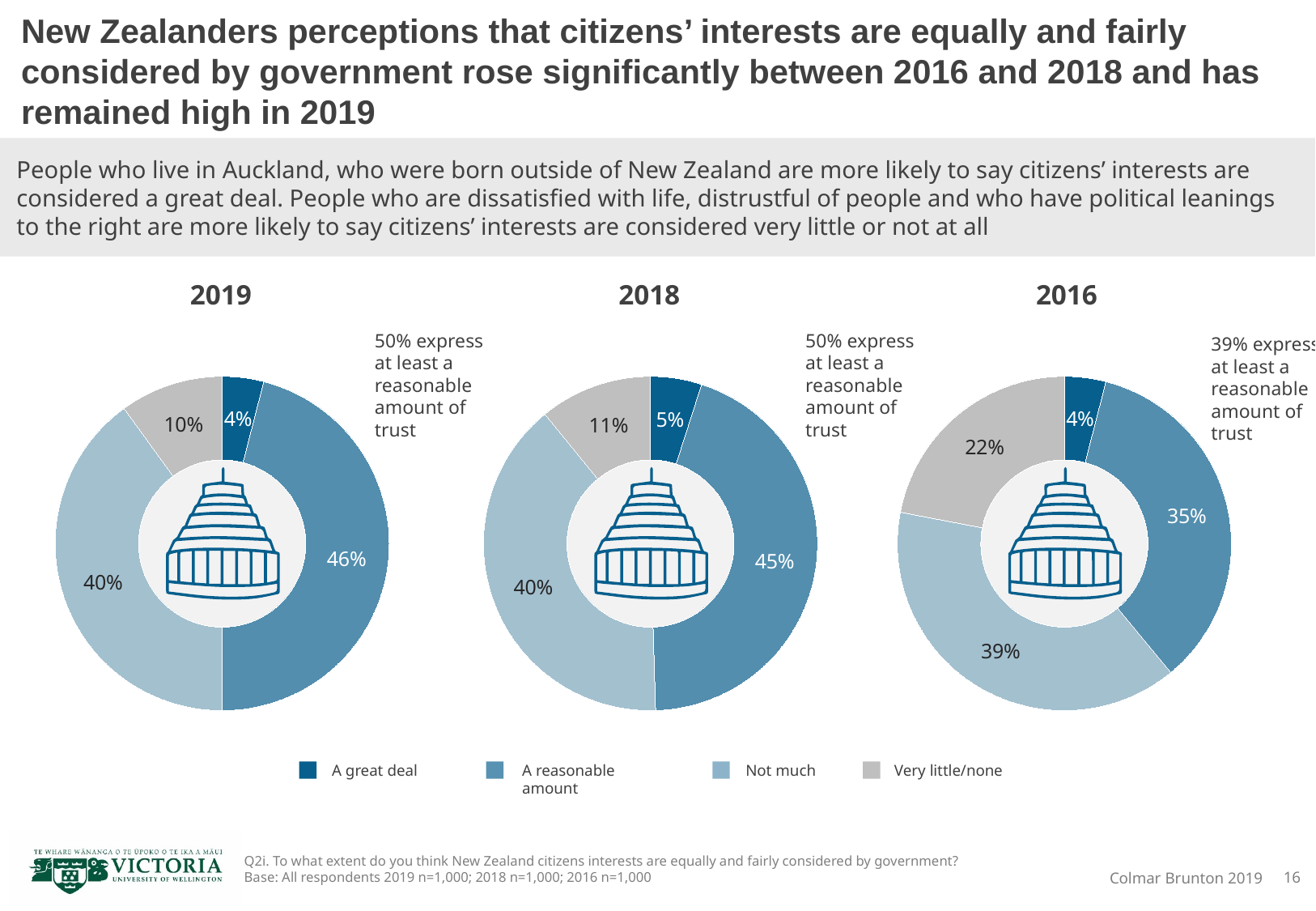
In the 2019 chart, which category has the smallest share? A great deal What is the difference between the 'Very little/none' share in the 2016 chart and in the 2019 chart? 12 percentage points In the 2016 chart, what is the combined share of 'A great deal' and 'A reasonable amount'? 39% In the 2018 chart, what percentage of respondents said 'A great deal'? 5% How many charts are shown on the slide? 3 In the 2016 chart, what percentage of respondents said 'Very little/none'? 22% Which is larger in the 2018 chart: the 'A reasonable amount' share or the 'Not much' share? A reasonable amount How many categories does the legend list? 4 What type of chart is used to show the 2019 results? Donut (pie) chart Which legend category is shown in grey? Very little/none In the 2016 chart, which category has the largest share? Not much In the 2019 chart, what percentage of respondents said 'A reasonable amount'? 46%